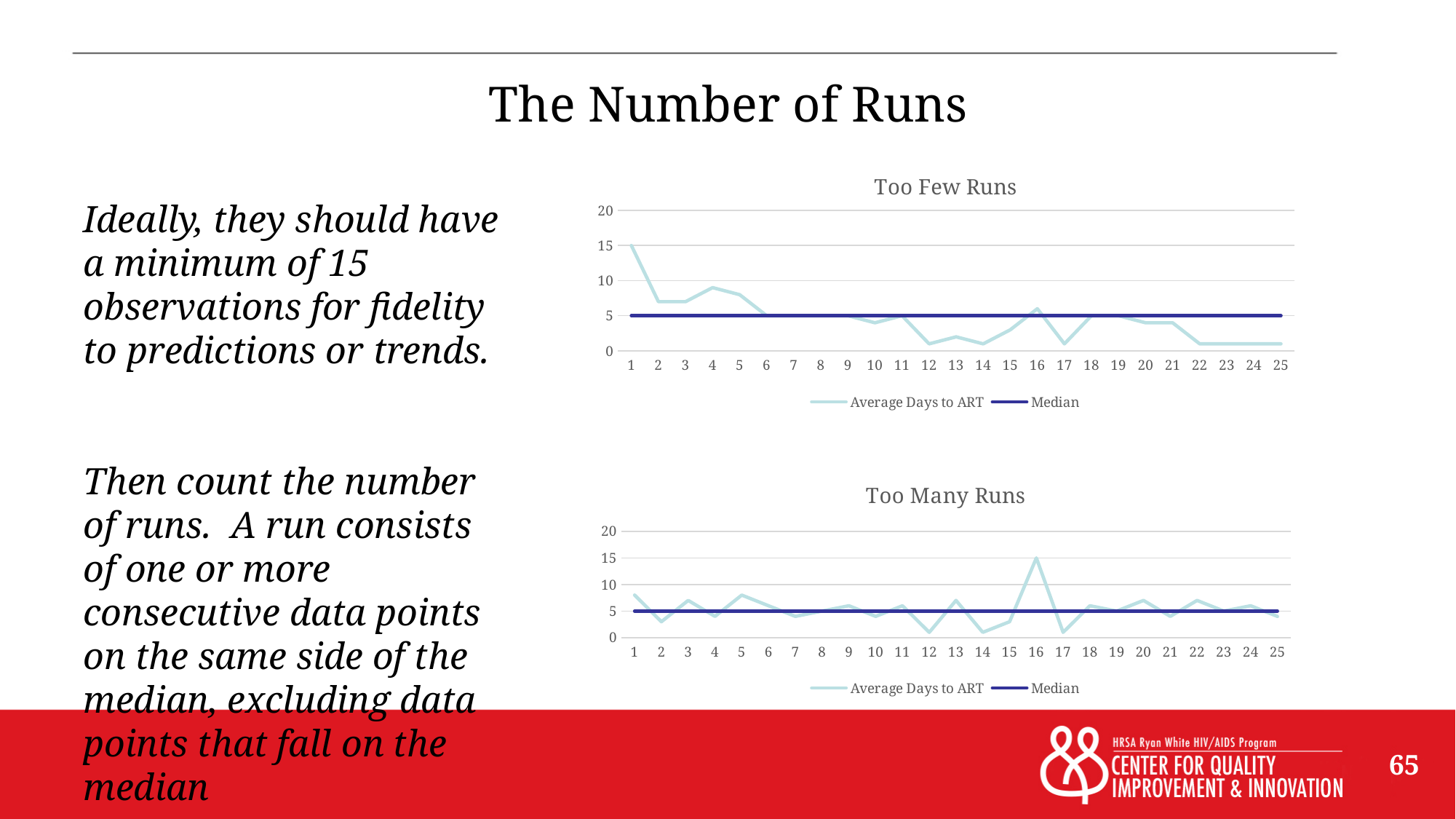
In the "Too Few Runs" chart, is the value for Average Days to ART at point 12 greater or less than 5? less In the "Too Many Runs" chart, what is the value of Average Days to ART at point 16? 15 What are the two legend entries shown under the "Too Many Runs" chart? Average Days to ART and Median In the "Too Few Runs" chart, does Average Days to ART generally rise or fall from point 1 to point 25? fall In the "Too Many Runs" chart, is the value for Average Days to ART at point 16 greater or less than 10? greater In the "Too Many Runs" chart, at which point is Average Days to ART highest? 16 What type of chart is the "Too Few Runs" chart? line chart How many series does the legend of the "Too Many Runs" chart list? 2 In the "Too Few Runs" chart, what is the value of Average Days to ART at point 1? 15 In the "Too Few Runs" chart, what value does the Median line sit at? 5 How many data points are plotted along the x axis of the "Too Few Runs" chart? 25 In the "Too Few Runs" chart, at which point is Average Days to ART highest? 1